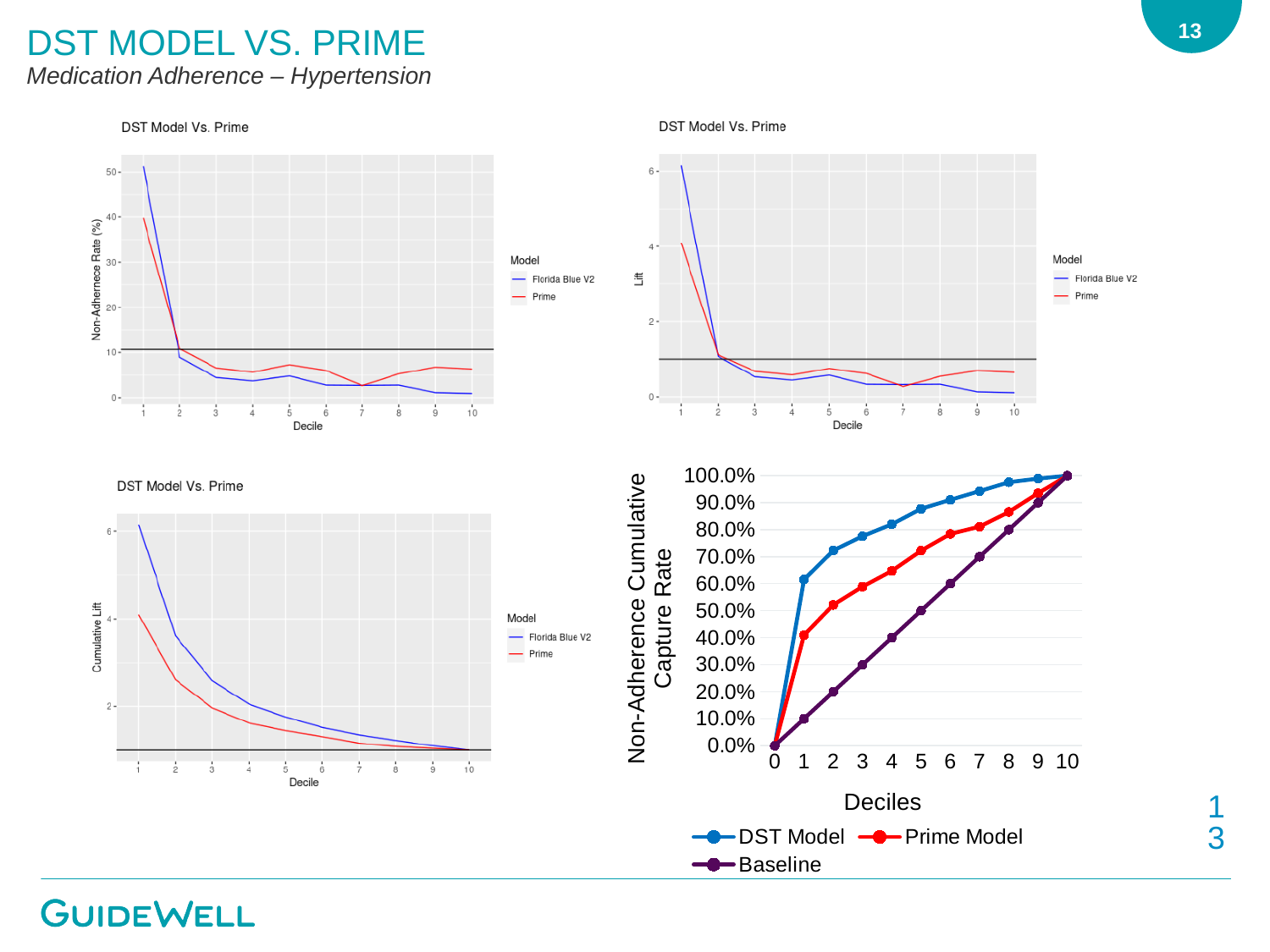
In the bottom-right chart (Non-Adherence Cumulative Capture Rate), how many series does the legend list? 3 In the bottom-left chart (Cumulative Lift), do the values rise or fall as the decile increases? fall In the top-left chart (Non-Adherence Rate), which model has the higher value at decile 1, Florida Blue V2 or Prime? Florida Blue V2 In the bottom-right chart (Non-Adherence Cumulative Capture Rate), is the Prime Model value at decile 1 greater or less than 50.0%? less In the bottom-right chart (Non-Adherence Cumulative Capture Rate), how many decile points are plotted on the x axis, from 0 to 10? 11 In the top-right chart (Lift), is the Florida Blue V2 value at decile 1 greater or less than 4? greater In the bottom-right chart (Non-Adherence Cumulative Capture Rate), which series has the higher value at decile 3, DST Model or Prime Model? DST Model In the bottom-right chart (Non-Adherence Cumulative Capture Rate), what is the Baseline value at decile 5? 50.0% What kind of chart is the bottom-right chart (Non-Adherence Cumulative Capture Rate)? line chart In the bottom-right chart (Non-Adherence Cumulative Capture Rate), which series has the lowest value at decile 4? Baseline In the bottom-right chart (Non-Adherence Cumulative Capture Rate), what is the DST Model value at decile 10? 100.0% In the bottom-right chart (Non-Adherence Cumulative Capture Rate), is the DST Model value at decile 1 greater or less than 50.0%? greater